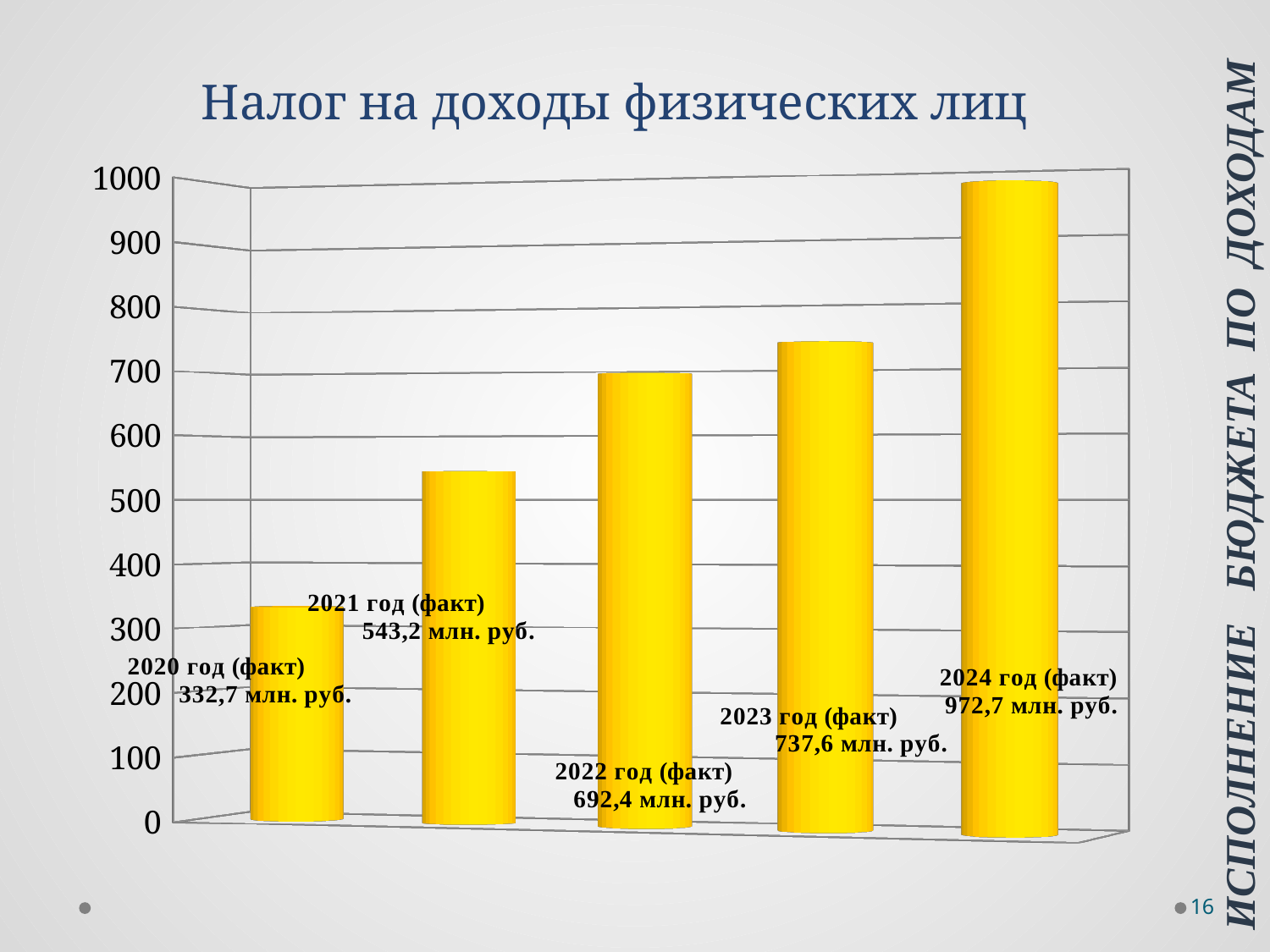
Do the values rise or fall from 2020 to 2024? rise What kind of chart is shown on the slide? bar chart Which year has the lowest value? 2020 год (факт) Is the value for 2021 год (факт) greater or less than 500? greater What is the value for 2024 год (факт)? 972,7 млн. руб. Which is larger, the value for 2021 год (факт) or 2023 год (факт)? 2023 год (факт) What is the difference between the values for 2024 год (факт) and 2020 год (факт)? 640,0 млн. руб. Which year has the highest value? 2024 год (факт) What is the value for 2020 год (факт)? 332,7 млн. руб. What is the difference between the values for 2023 год (факт) and 2022 год (факт)? 45,2 млн. руб. What is the value for 2022 год (факт)? 692,4 млн. руб. How many bars are shown in the chart? 5